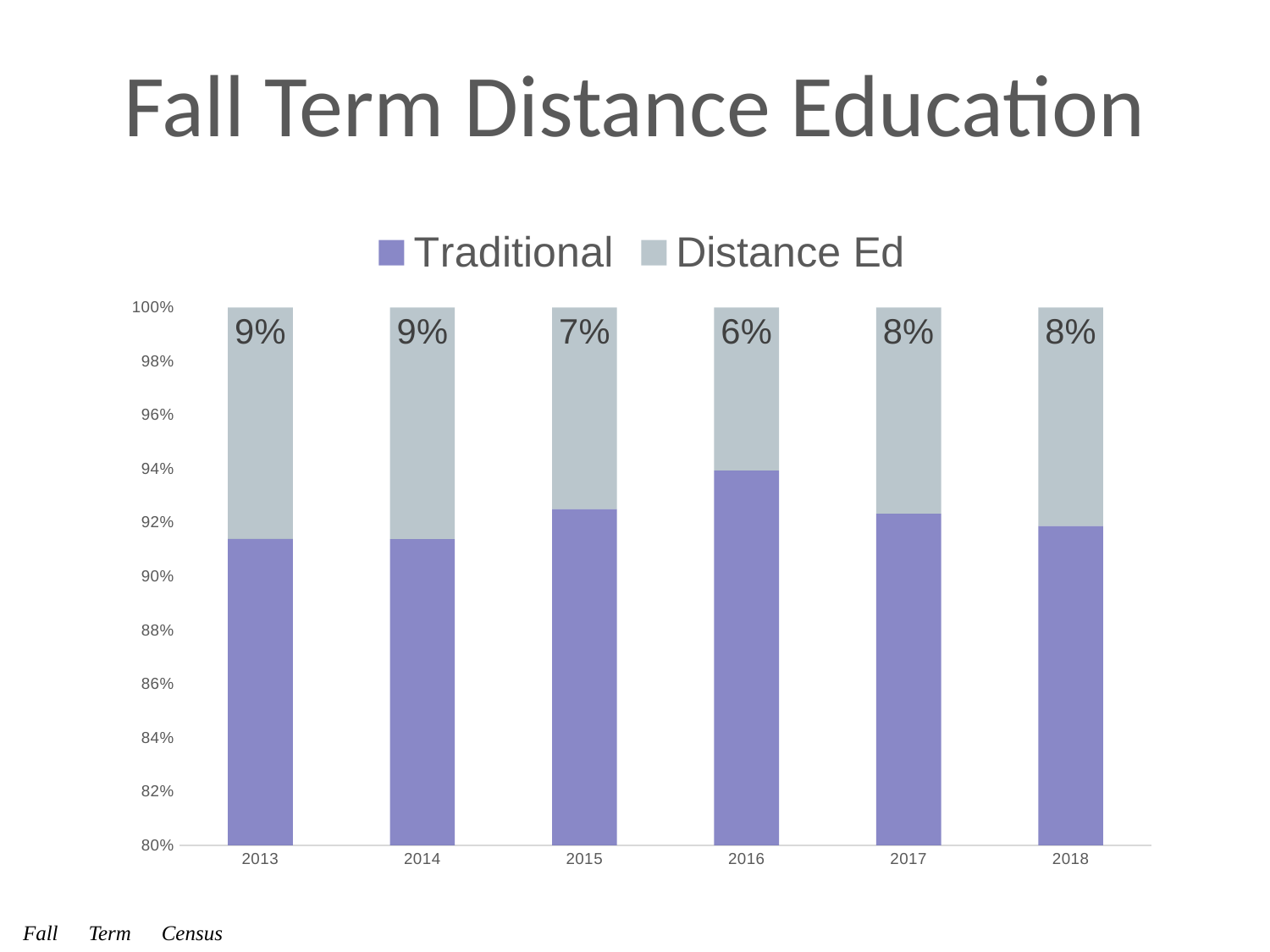
How many series does the legend list? 2 Is the Traditional value for 2016 greater or less than 92%? greater Which year has the highest Traditional value? 2016 Which year has the lowest Distance Ed value? 2016 What is the difference between the Distance Ed values for 2013 and 2016? 3% How many years are shown on the x axis? 6 What is the Distance Ed value for 2016? 6% Is the Traditional value for 2013 greater or less than 94%? less What is the Distance Ed value for 2017? 8% What is the Distance Ed value for 2013? 9% What kind of chart is shown on the slide? Stacked bar chart Which is larger, the Distance Ed value for 2015 or for 2017? 2017